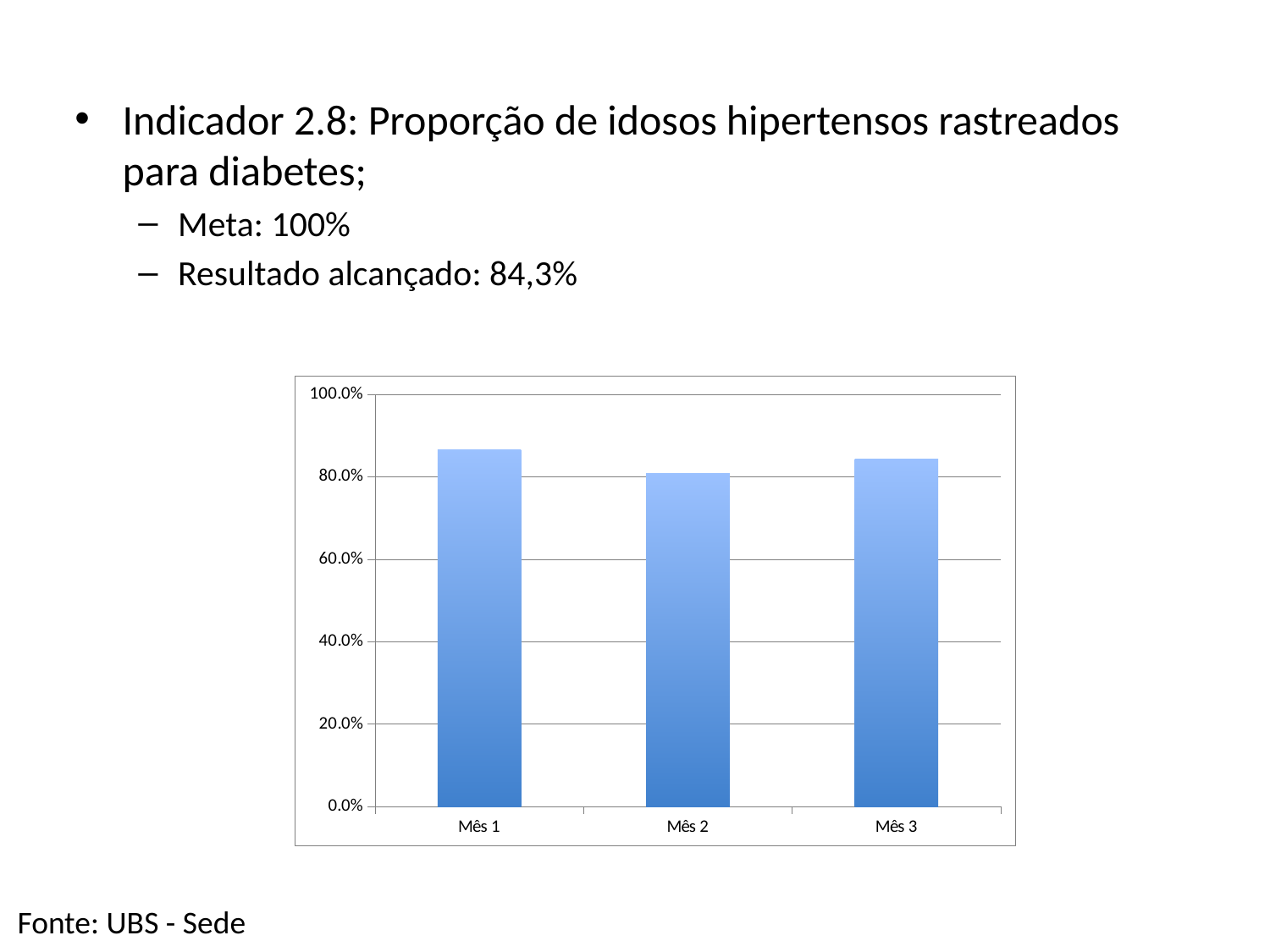
Does the value rise or fall from Mês 1 to Mês 2? fall Does the value rise or fall from Mês 2 to Mês 3? rise Which is larger, the value for Mês 1 or the value for Mês 2? Mês 1 What are the category labels on the chart's horizontal axis? Mês 1, Mês 2, Mês 3 Is the value for Mês 3 greater or less than 100.0%? less How many categories (months) are plotted on the chart? 3 Which month has the lowest bar on the chart? Mês 2 What is the highest value shown on the chart's vertical axis? 100.0% What kind of chart is shown on the slide? bar chart Is the value for Mês 1 greater or less than 80.0%? greater Is the value for Mês 2 greater or less than 60.0%? greater Which month has the highest bar on the chart? Mês 1